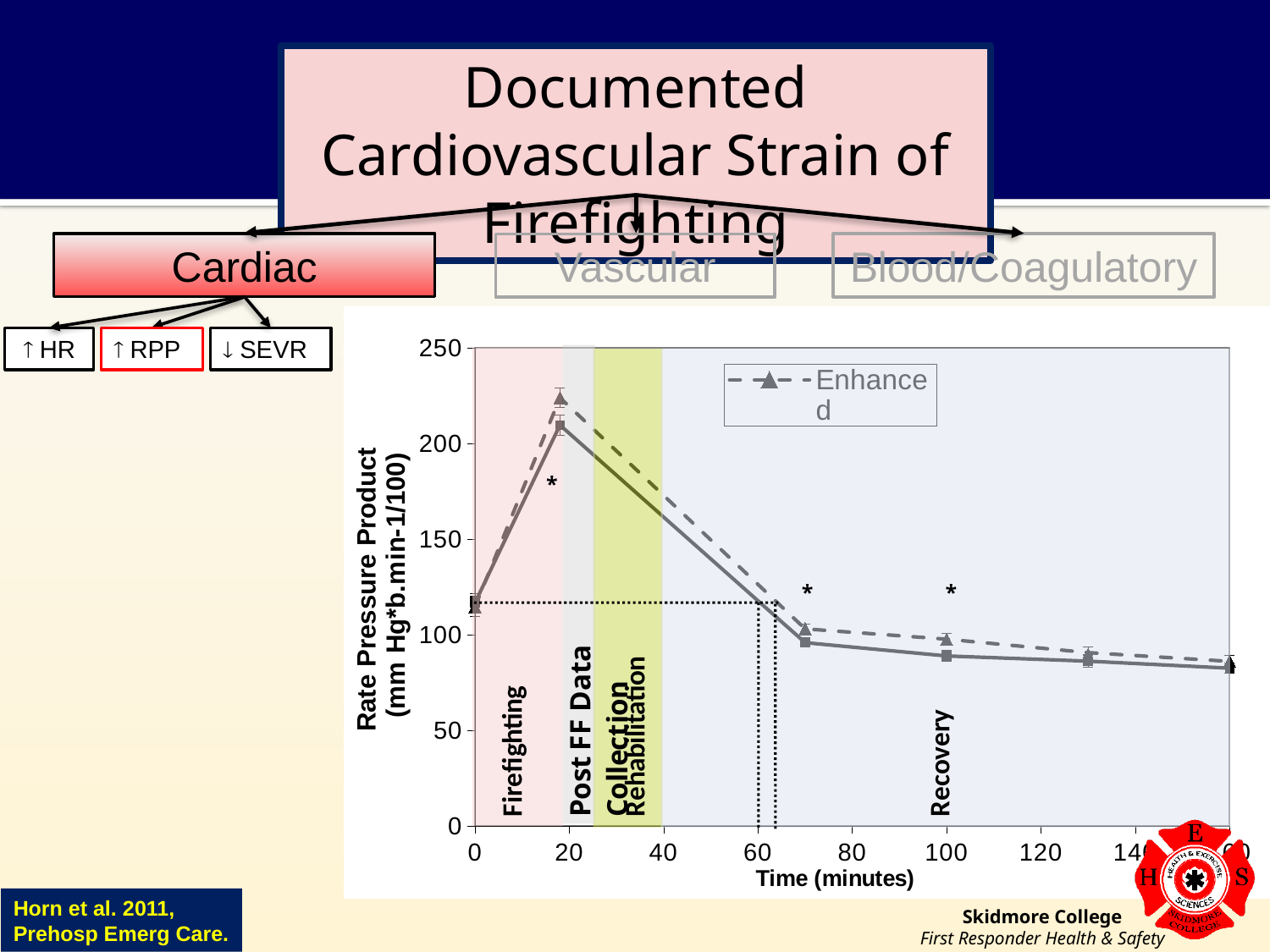
Is the value of the Enhanced series at time 0 greater or less than 100? greater How many data points are plotted for the Enhanced series? 6 What is the title of the x axis of the chart? Time (minutes) Do the values of the Enhanced series rise or fall between 20 minutes and 160 minutes? fall Is the peak value of the Enhanced series greater or less than 200? greater What kind of chart is shown on the slide? line chart Is the value of the solid-line series at 100 minutes greater or less than 100? less Do the values of the Enhanced series rise or fall between 0 and 20 minutes? rise Which series is drawn with a dashed line and triangle markers according to the legend? Enhanced At the peak near 20 minutes, which series has the higher Rate Pressure Product, the Enhanced series or the solid-line series? Enhanced